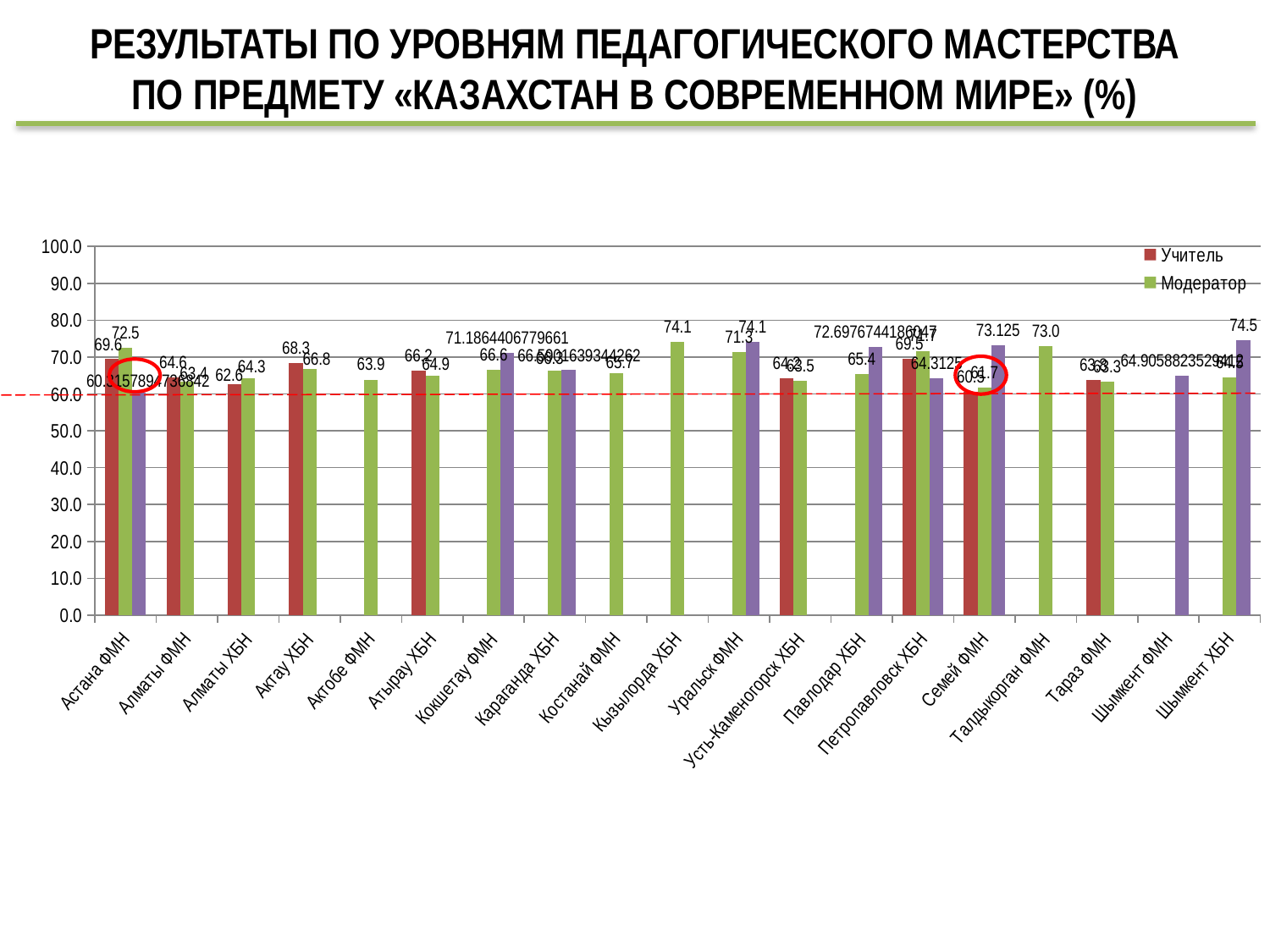
Which category has the highest Модератор value? Кызылорда ХБН How many series does the legend list? 2 What is the Модератор value for Кызылорда ХБН? 74.1 What is the Модератор value for Актобе ФМН? 63.9 What is the difference between the Модератор and Учитель values for Астана ФМН? 2.9 For Актау ХБН, which is larger: the Учитель value or the Модератор value? Учитель What is the Учитель value for Астана ФМН? 69.6 What kind of chart is shown on the slide? bar chart At what value on the y axis is the horizontal red dashed line drawn? 60.0 How many categories (cities/schools) are shown along the x axis? 19 What is the Модератор value for Талдыкорган ФМН? 73.0 Is the Модератор value for Костанай ФМН greater or less than 70? less